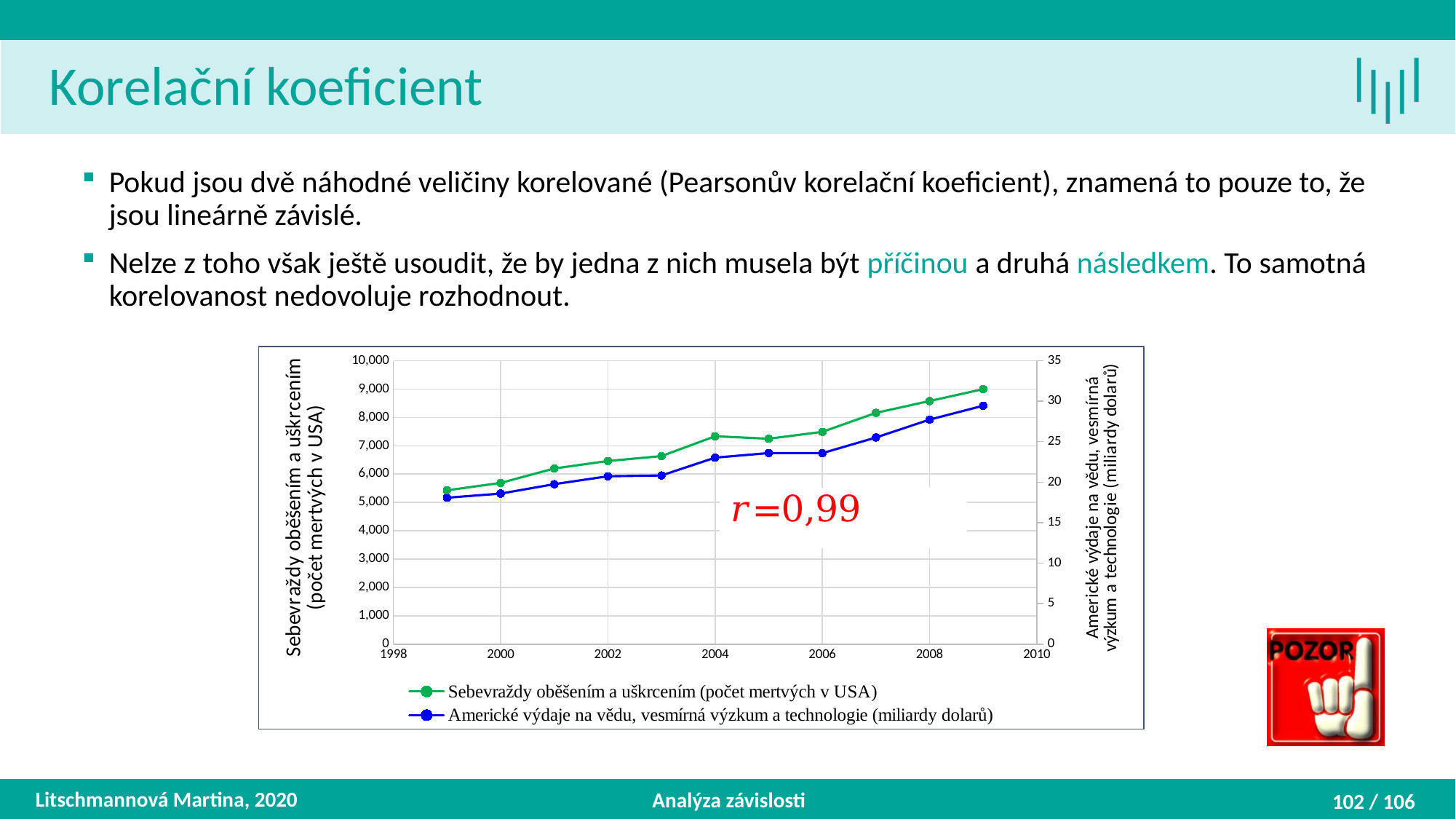
Is the value for 'Sebevraždy oběšením a uškrcením' in 1999 greater or less than 5,000? greater How many series does the chart legend list? 2 Do the values of the series 'Americké výdaje na vědu, vesmírná výzkum a technologie' rise or fall from 1999 to 2009? rise Do the values of the series 'Sebevraždy oběšením a uškrcením' rise or fall from 1999 to 2009? rise Is the value for 'Americké výdaje na vědu, vesmírná výzkum a technologie' in 1999 greater or less than 20 (right axis)? less What kind of chart is shown on the slide? line chart Is the value for 'Americké výdaje na vědu, vesmírná výzkum a technologie' in 2009 greater or less than 25 (right axis)? greater What correlation coefficient value is printed in red on the chart? r=0,99 In which year is the value of the series 'Americké výdaje na vědu, vesmírná výzkum a technologie' lowest? 1999 In which year is the value of the series 'Sebevraždy oběšením a uškrcením' highest? 2009 How many data points does each series in the chart have? 11